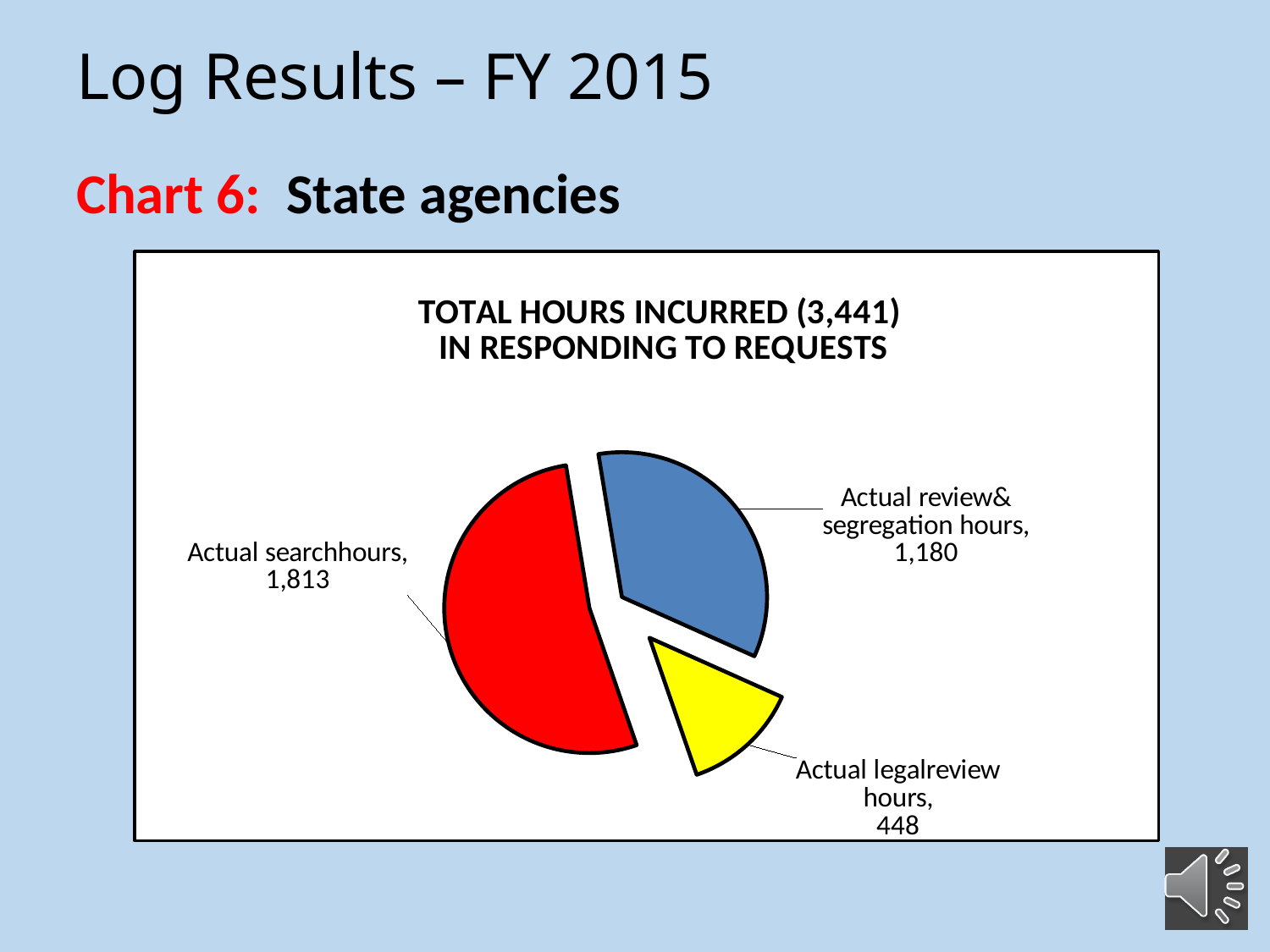
Which category accounts for the fewest hours? Actual legal review hours How many actual search hours are shown? 1,813 What is the difference between actual search hours and actual review & segregation hours? 633 What type of chart is shown on the slide? pie chart How many actual review & segregation hours are shown? 1,180 How many actual legal review hours are shown? 448 Which is larger, actual review & segregation hours or actual legal review hours? Actual review & segregation hours What colour is the slice for actual search hours? red What is the difference between actual review & segregation hours and actual legal review hours? 732 What is the title of the chart? TOTAL HOURS INCURRED (3,441) IN RESPONDING TO REQUESTS How many slices does the pie chart have? 3 Which category accounts for the most hours? Actual search hours